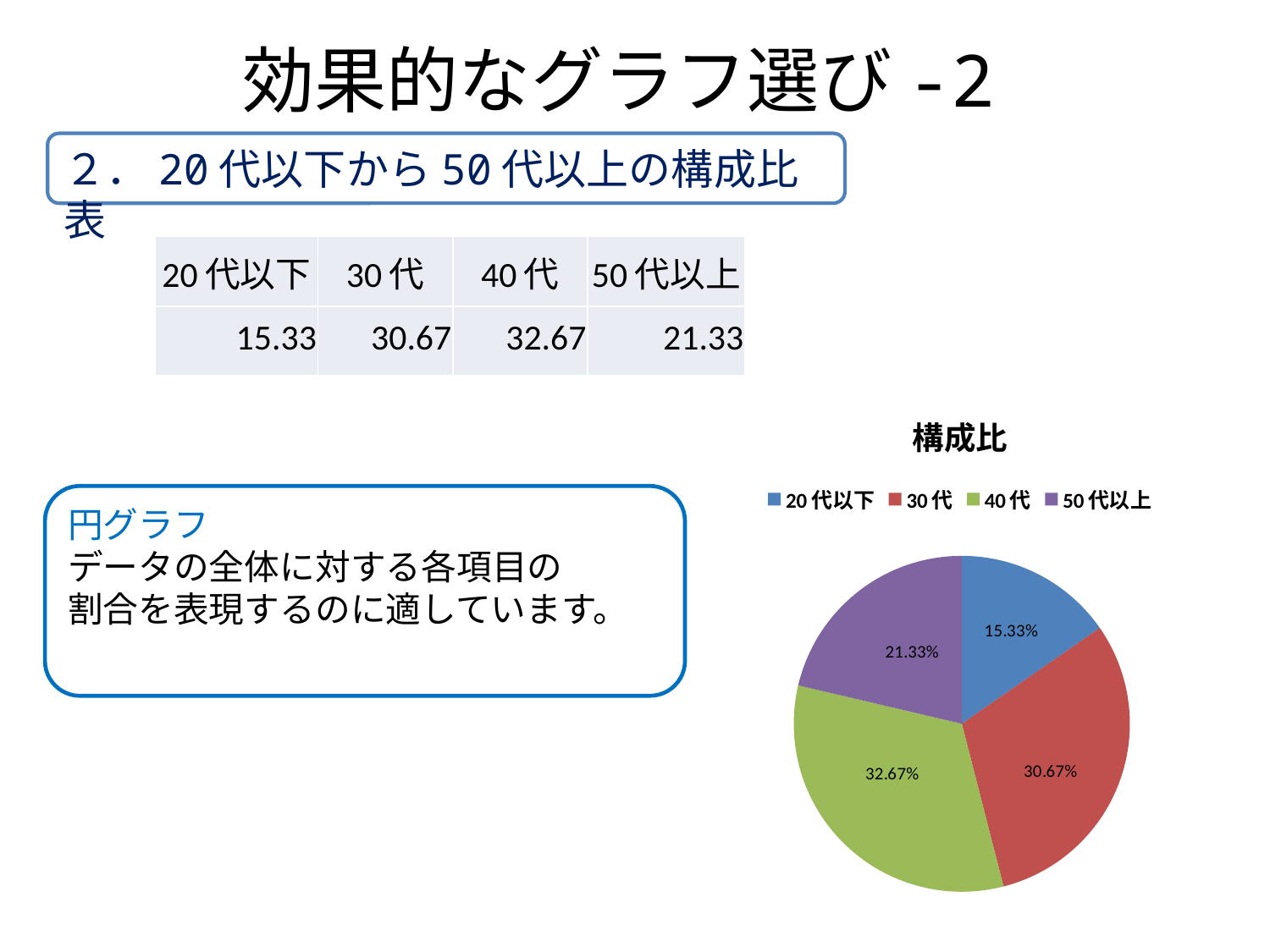
What is the difference between the values for 50代以上 and 20代以下 in the pie chart? 6.00% What is the title of the chart on the slide? 構成比 What is the value shown for 30代 in the pie chart? 30.67% Which category has the smallest slice in the pie chart? 20代以下 How many slices does the pie chart have? 4 What is the value shown for 40代 in the pie chart? 32.67% What is the value shown for 50代以上 in the pie chart? 21.33% Which category has the largest slice in the pie chart? 40代 What is the value shown for 20代以下 in the pie chart? 15.33% How many entries does the legend of the pie chart list? 4 Which is larger in the pie chart, the slice for 30代 or the slice for 20代以下? 30代 What kind of chart is shown on the slide? Pie chart